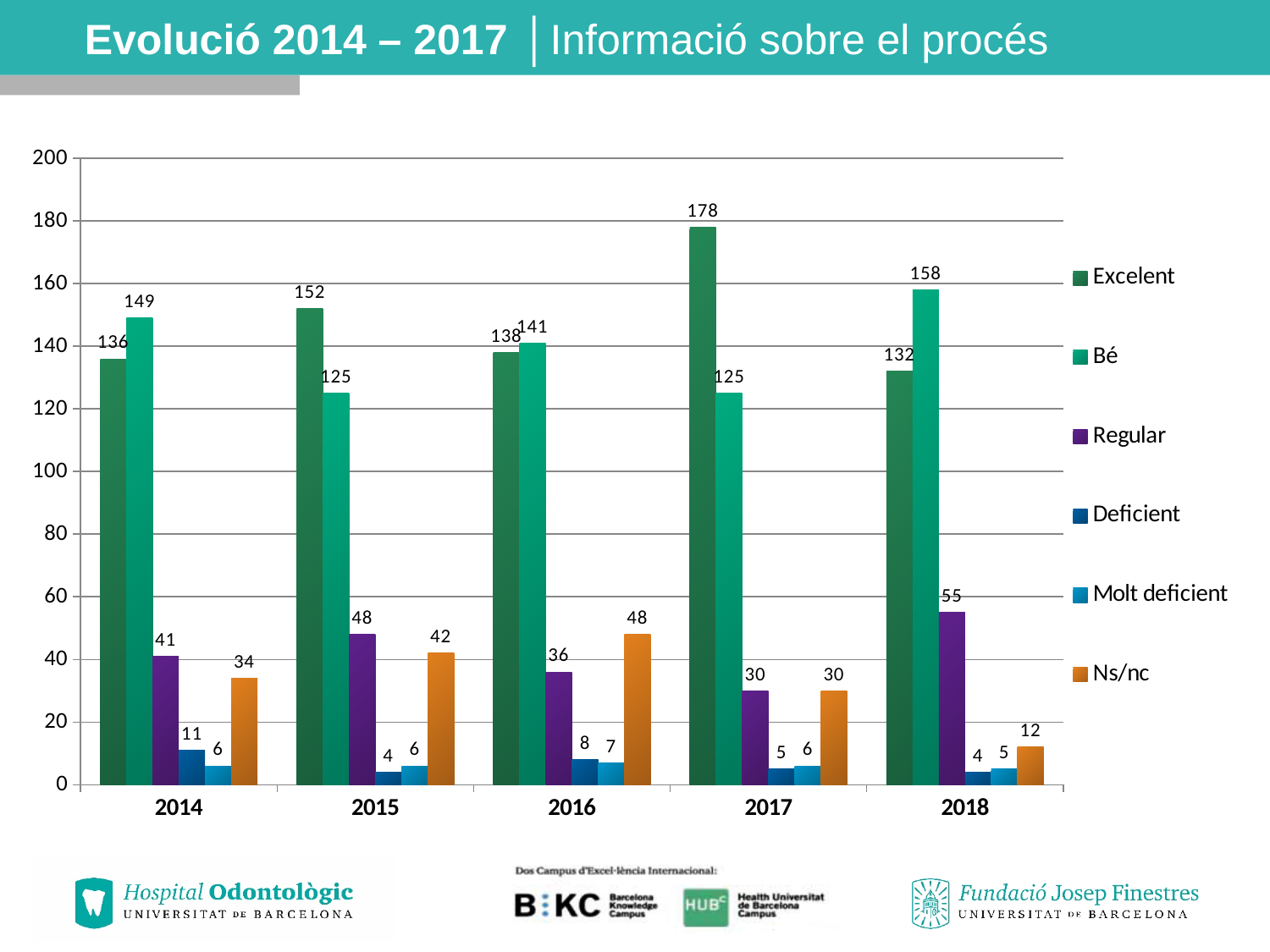
How many years are shown on the x axis? 5 In which year is the Ns/nc value lowest? 2018 What is the value for Bé in 2018? 158 What kind of chart is shown on the slide? Bar chart What is the value for Ns/nc in 2016? 48 What is the value for Excelent in 2017? 178 In which year is the Excelent value highest? 2017 What is the value for Deficient in 2014? 11 How many series does the legend list? 6 Which is larger in 2014, Excelent or Bé? Bé Which legend entry is shown in orange? Ns/nc What is the difference between the Excelent and Bé values in 2017? 53